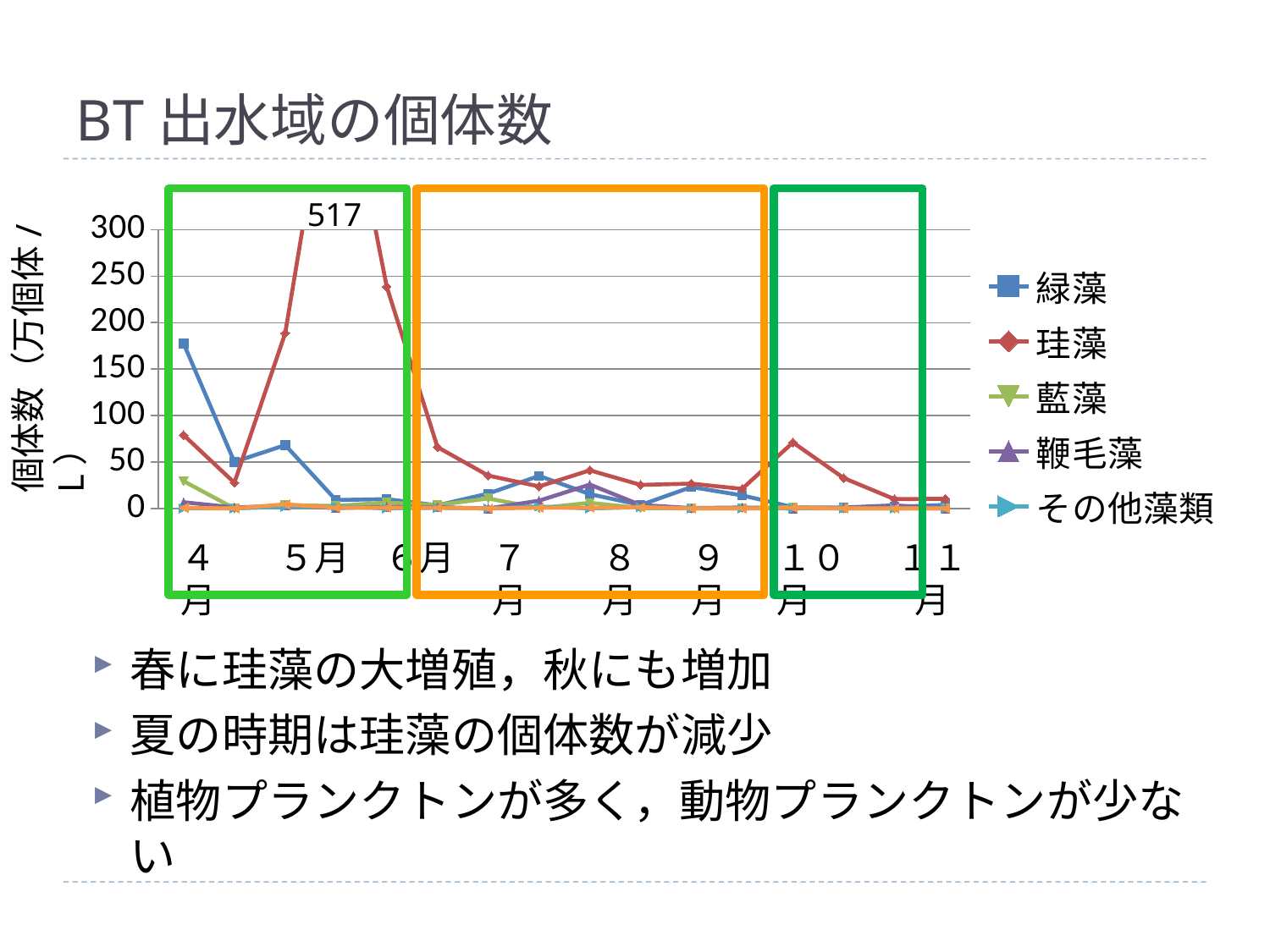
Is the value for 珪藻 at 10月 greater or less than 50? greater Is the value for 珪藻 at 4月 greater or less than 100? less What kind of chart is shown on the slide? line chart Which series is drawn in red with diamond markers? 珪藻 What is the peak value labelled on the 珪藻 line in 5月? 517 Which series reaches the highest value in the chart? 珪藻 Is the value for 緑藻 at 4月 greater or less than 150? greater How many series does the legend list? 5 Does the 珪藻 line rise or fall from 6月 to 7月? fall At 4月, which is larger: 緑藻 or 珪藻? 緑藻 What is the title of the slide containing the chart? BT 出水域の個体数 How many months are labelled on the x axis? 8